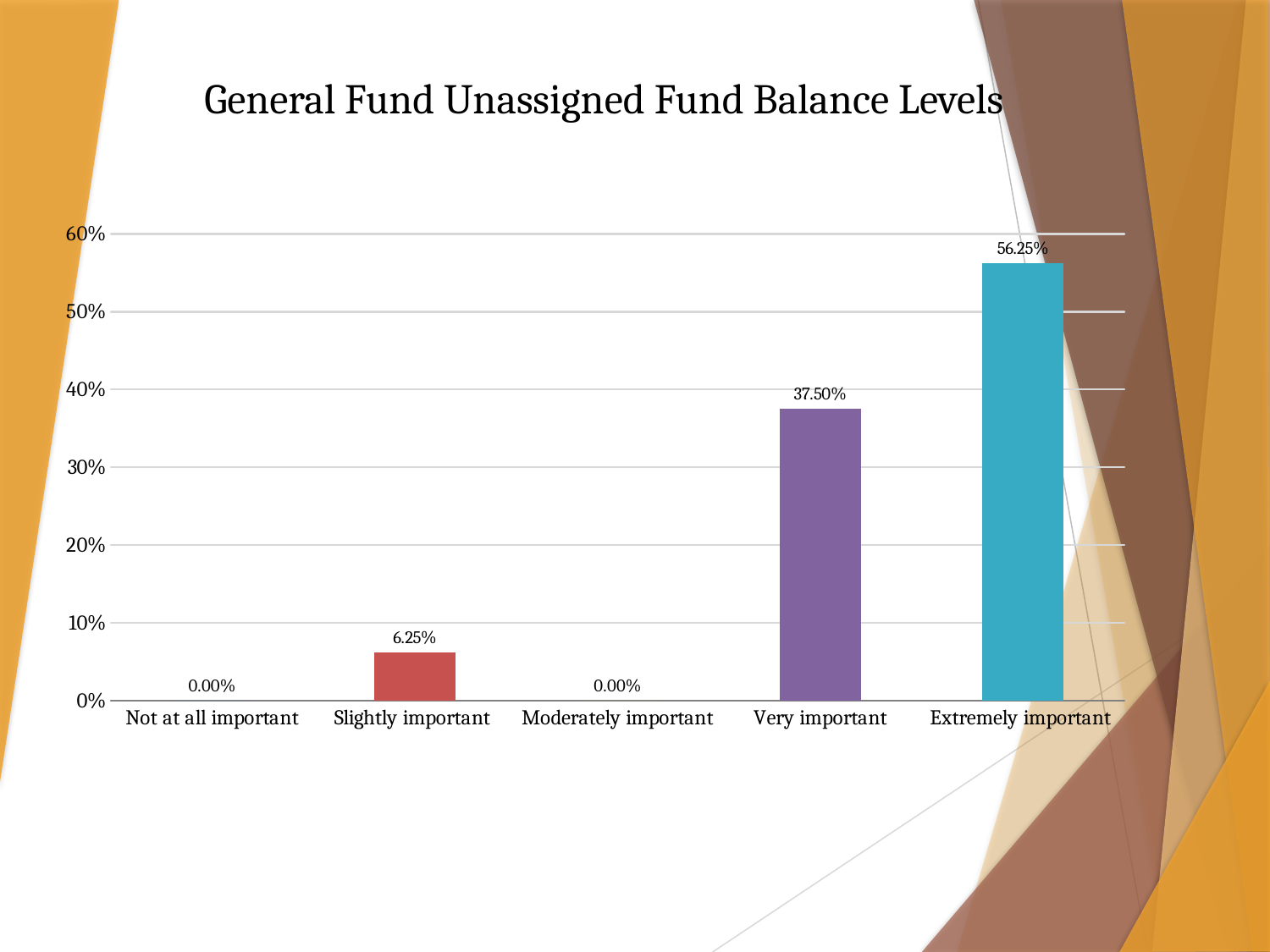
Which is larger, the value for Slightly important or the value for Very important? Very important Which category has the highest value? Extremely important What kind of chart is shown on the slide? bar chart What is the difference between the values for Extremely important and Very important? 18.75% What colour is the bar for Extremely important? teal Is the value for Very important greater or less than 40%? less What is the title of the chart? General Fund Unassigned Fund Balance Levels How many categories are shown on the x axis? 5 What is the value for Very important? 37.50% What is the value for Moderately important? 0.00% What is the value for Slightly important? 6.25% What is the value for Extremely important? 56.25%